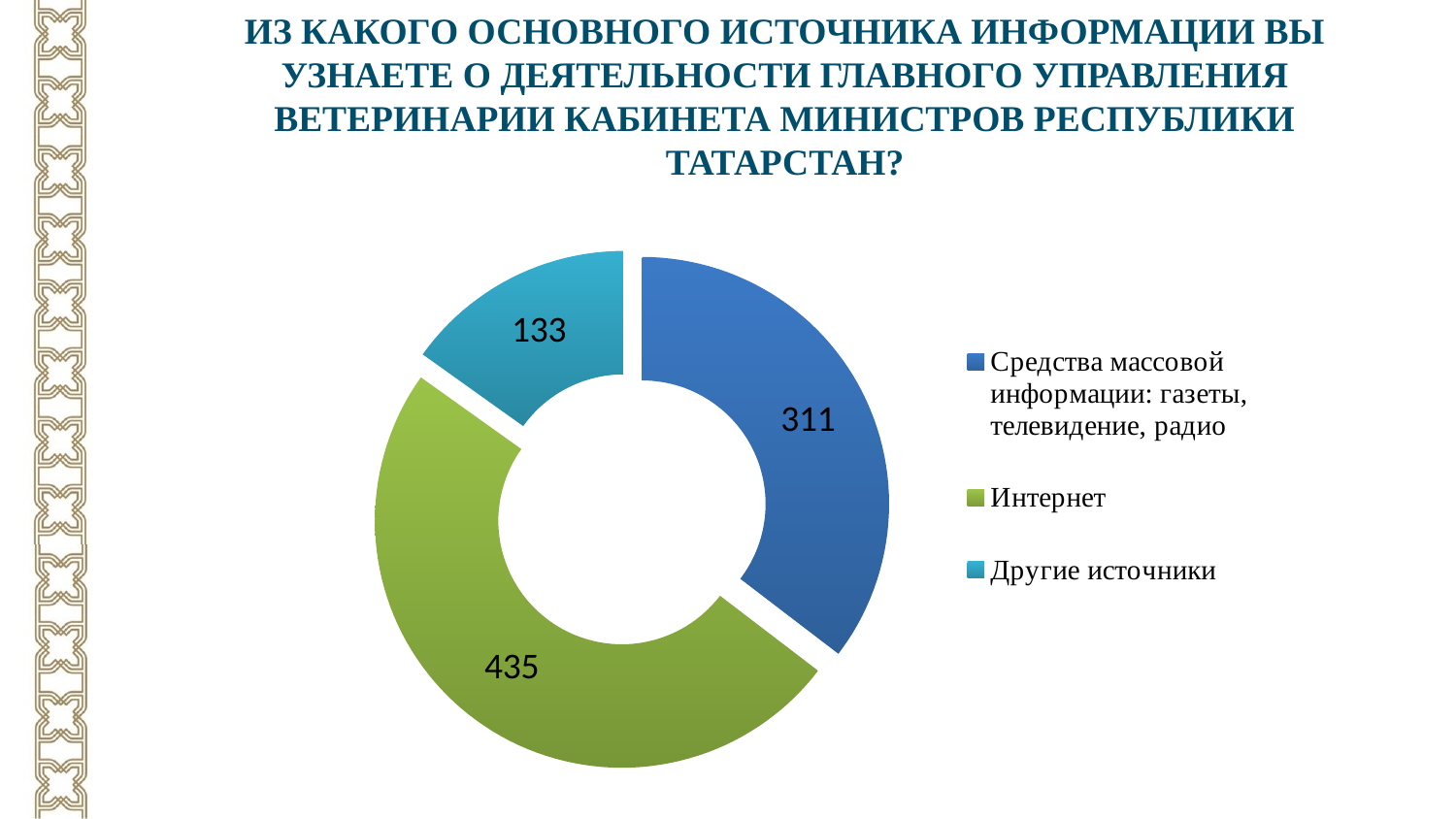
Which is larger: the value for Интернет or the value for Другие источники? Интернет What colour is the slice for Интернет? Green What is the difference between the values for Интернет and Средства массовой информации? 124 What is the value for Интернет? 435 What is the difference between the values for Средства массовой информации and Другие источники? 178 Which source has the highest value? Интернет Which source has the lowest value? Другие источники What is the value for Средства массовой информации: газеты, телевидение, радио? 311 What type of chart is shown on the slide? Doughnut (pie) chart What is the value for Другие источники? 133 What is the total of all three values in the chart? 879 How many categories does the chart show? 3